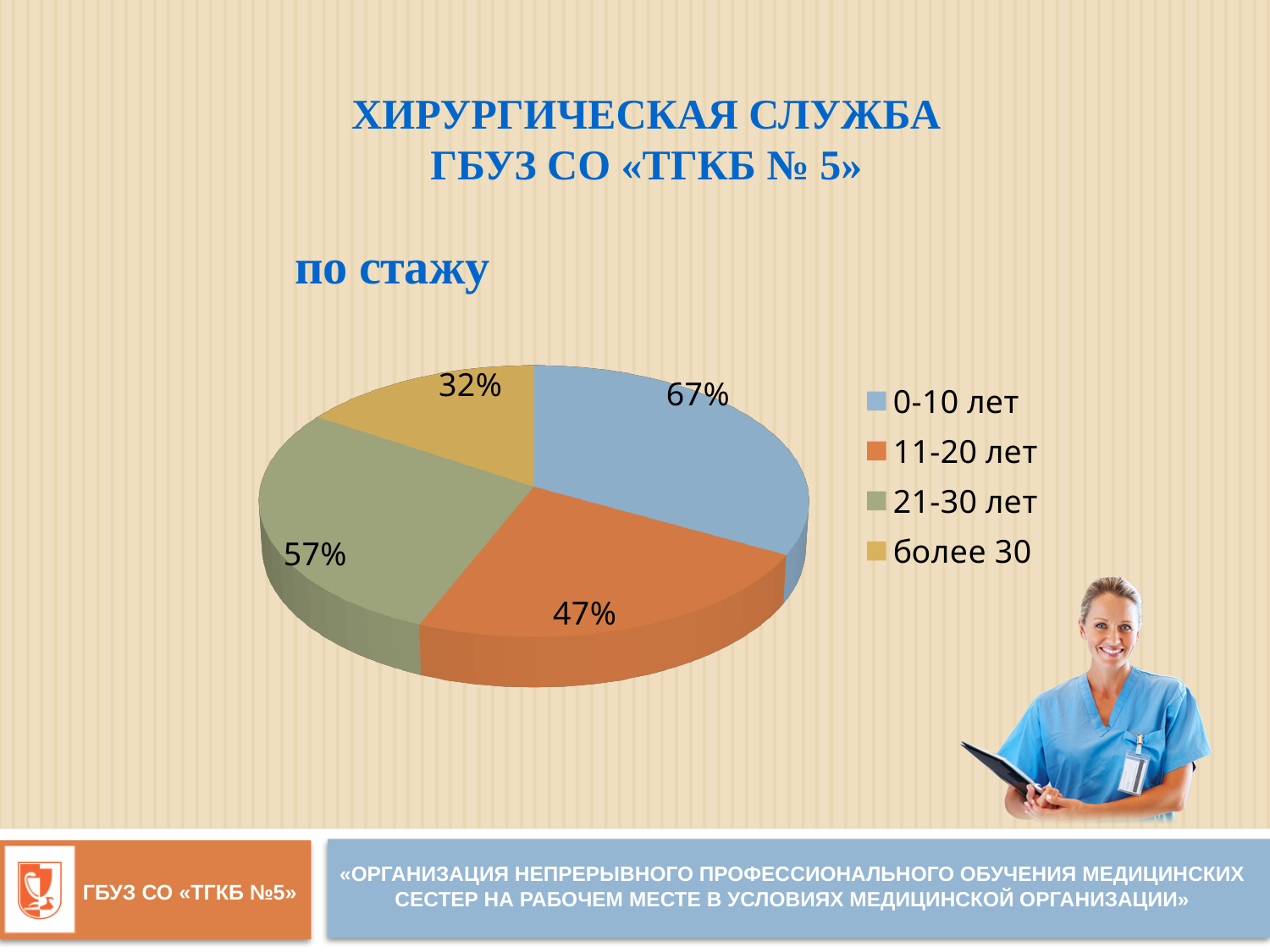
What value is shown for the 11-20 лет slice? 47% What value is shown for the 21-30 лет slice? 57% Which is larger: the value for 21-30 лет or the value for 11-20 лет? 21-30 лет Which category has the highest value in the pie chart? 0-10 лет What is the difference between the values for 21-30 лет and более 30? 25% What is the difference between the values for 0-10 лет and 11-20 лет? 20% What is the title shown above the pie chart? по стажу How many slices does the pie chart have? 4 What type of chart is shown on the slide? pie chart What value is shown for the более 30 slice? 32% What value is shown for the 0-10 лет slice? 67% Which category has the lowest value in the pie chart? более 30